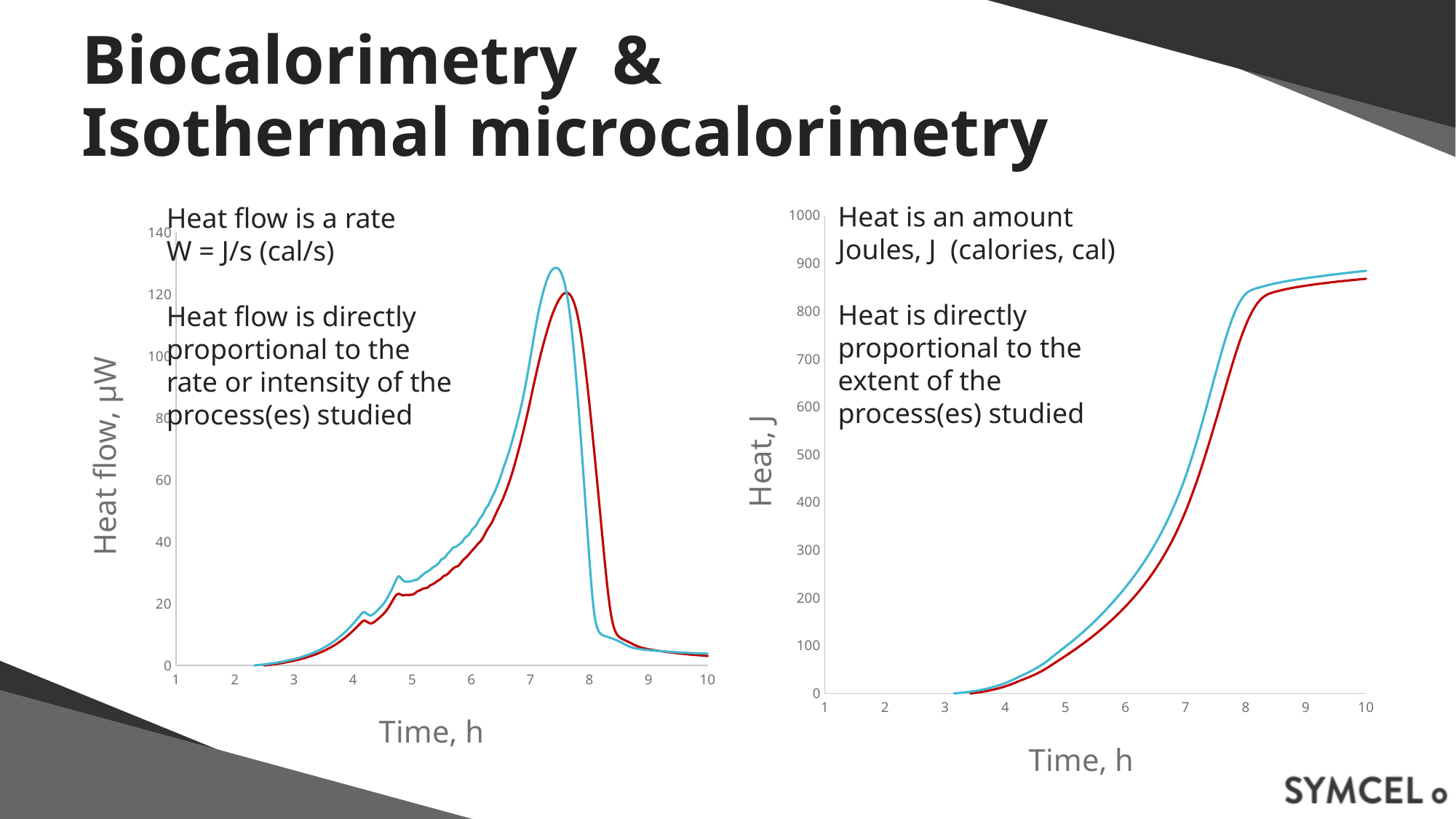
On the right chart (Heat, J), is the value of the blue line at time 4 h greater or less than 100? less What kind of chart is the right chart (Heat, J)? line chart What kind of chart is the left chart (Heat flow, µW)? line chart On the right chart (Heat, J), is the value of the red line at time 8 h greater or less than 700? greater What is the y-axis label of the left chart? Heat flow, µW On the left chart (Heat flow, µW), is the peak value of the blue line greater or less than 120? greater On the left chart (Heat flow, µW), which line reaches the higher peak, the blue line or the red line? the blue line On the right chart (Heat, J), do the plotted values rise or fall as time increases? rise